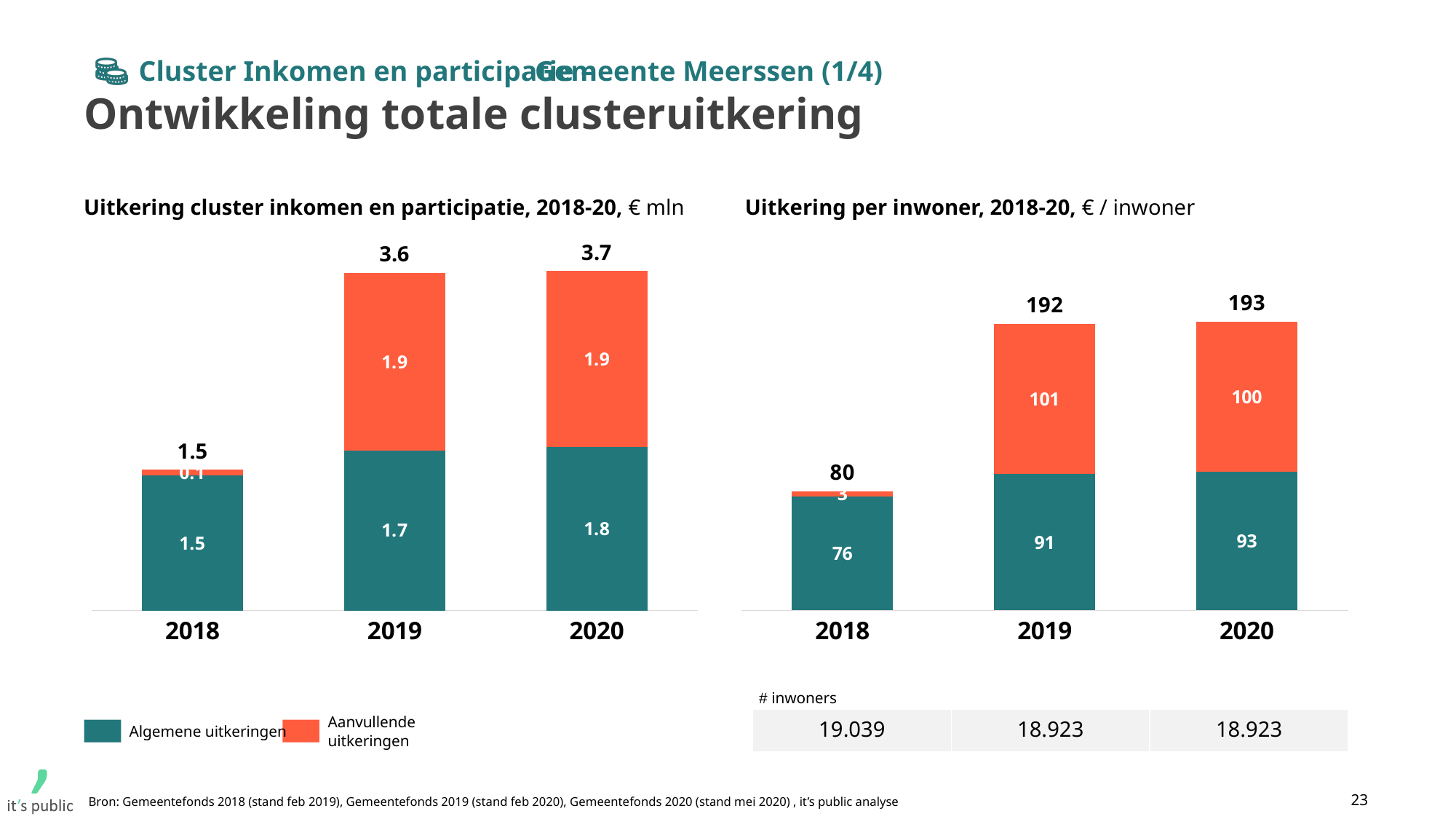
What kind of chart is the left chart (Uitkering cluster inkomen en participatie)? Stacked bar chart In the left chart (Uitkering cluster inkomen en participatie), which year has the lowest total? 2018 In the right chart (Uitkering per inwoner), what is the value of Aanvullende uitkeringen in 2020? 100 In the right chart (Uitkering per inwoner), is Aanvullende uitkeringen in 2019 larger than Algemene uitkeringen in 2019? Yes, 101 vs 91 In the right chart (Uitkering per inwoner), what is the total value for 2020? 193 How many years are shown on the x axis of the left chart? 3 In the right chart (Uitkering per inwoner), which year has the highest total? 2020 In the left chart (Uitkering cluster inkomen en participatie), what is the total value for 2019? 3.6 In the left chart (Uitkering cluster inkomen en participatie), what is the value of Aanvullende uitkeringen in 2019? 1.9 In the left chart (Uitkering cluster inkomen en participatie), what is the value of Algemene uitkeringen in 2020? 1.8 In the right chart (Uitkering per inwoner), what is the value of Algemene uitkeringen in 2018? 76 In the right chart (Uitkering per inwoner), what is the difference between the Algemene uitkeringen values for 2020 and 2019? 2